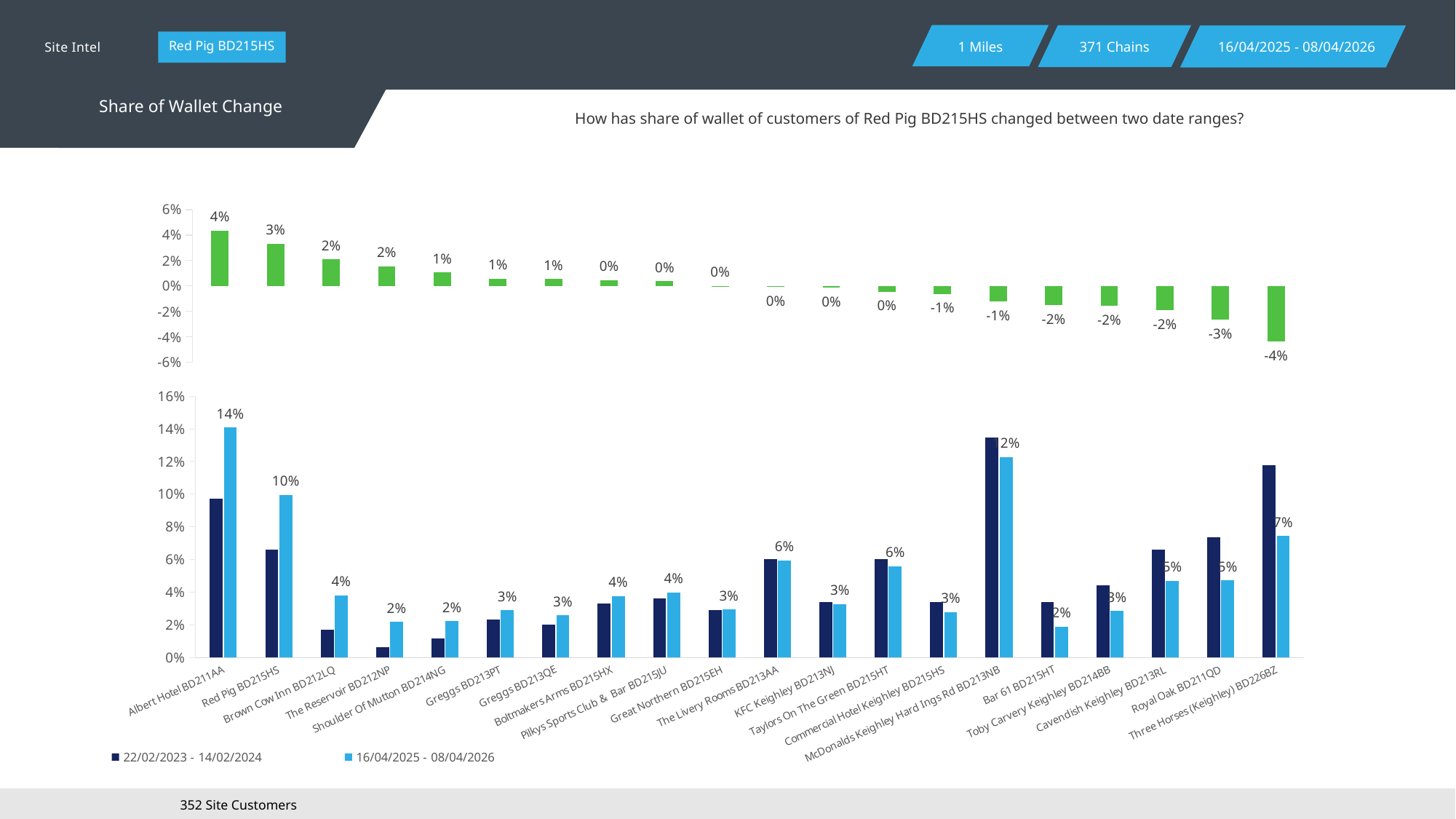
In the top chart, which category has the highest value? Albert Hotel BD211AA In the bottom chart, what is the value for McDonalds Keighley Hard Ings Rd BD213NB in the 16/04/2025 - 08/04/2026 series? 12% How many series does the legend of the bottom chart list? 2 In the top chart, what is the difference between the values for Red Pig BD215HS and Royal Oak BD211QD? 6% In the top chart, what is the value for Three Horses (Keighley) BD226BZ? -4% In the bottom chart, is the value for Three Horses (Keighley) BD226BZ in the 22/02/2023 - 14/02/2024 series greater or less than 10%? greater In the bottom chart, which category has the highest value in the 16/04/2025 - 08/04/2026 series? Albert Hotel BD211AA In the top chart, what is the value for Albert Hotel BD211AA? 4% In the bottom chart, is the value for Albert Hotel BD211AA in the 22/02/2023 - 14/02/2024 series greater or less than 8%? greater How many categories are shown on the x axis of the bottom chart? 20 In the bottom chart, what is the value for Red Pig BD215HS in the 16/04/2025 - 08/04/2026 series? 10% In the top chart, which category has the lowest value? Three Horses (Keighley) BD226BZ